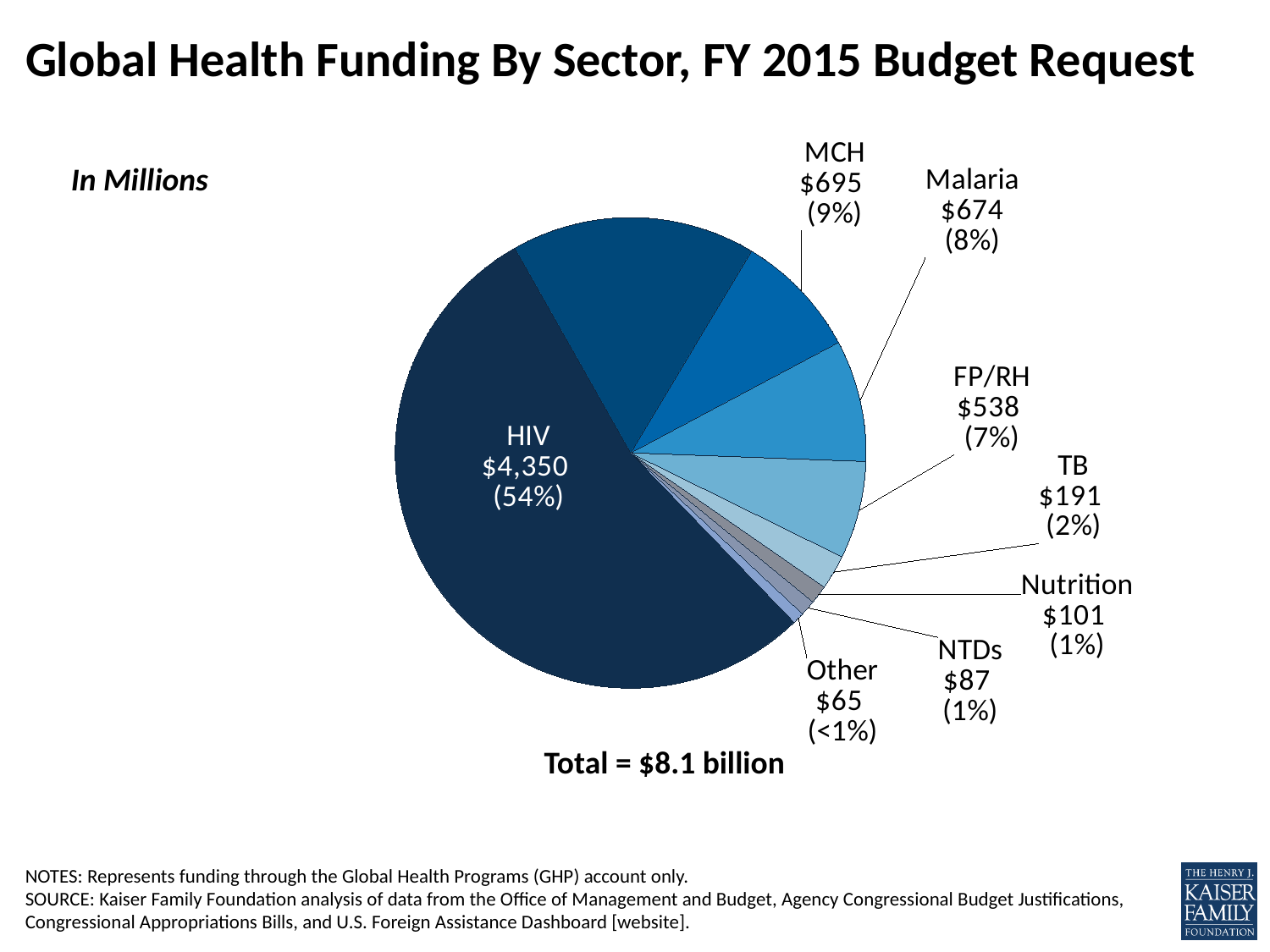
What is the funding value for HIV? $4,350 What is the funding value for Malaria? $674 Which sector has the largest share of the pie? HIV What is the funding value for TB? $191 Which is larger, the funding for Nutrition or for NTDs? Nutrition What total is stated below the pie chart? Total = $8.1 billion What share of the pie does FP/RH represent? 7% What kind of chart is shown on the slide? pie chart Which sector has the smallest share of the pie? Other What is the difference between the MCH and Malaria funding values? $21 How many sectors are shown in the pie chart? 9 What share of the pie does MCH represent? 9%